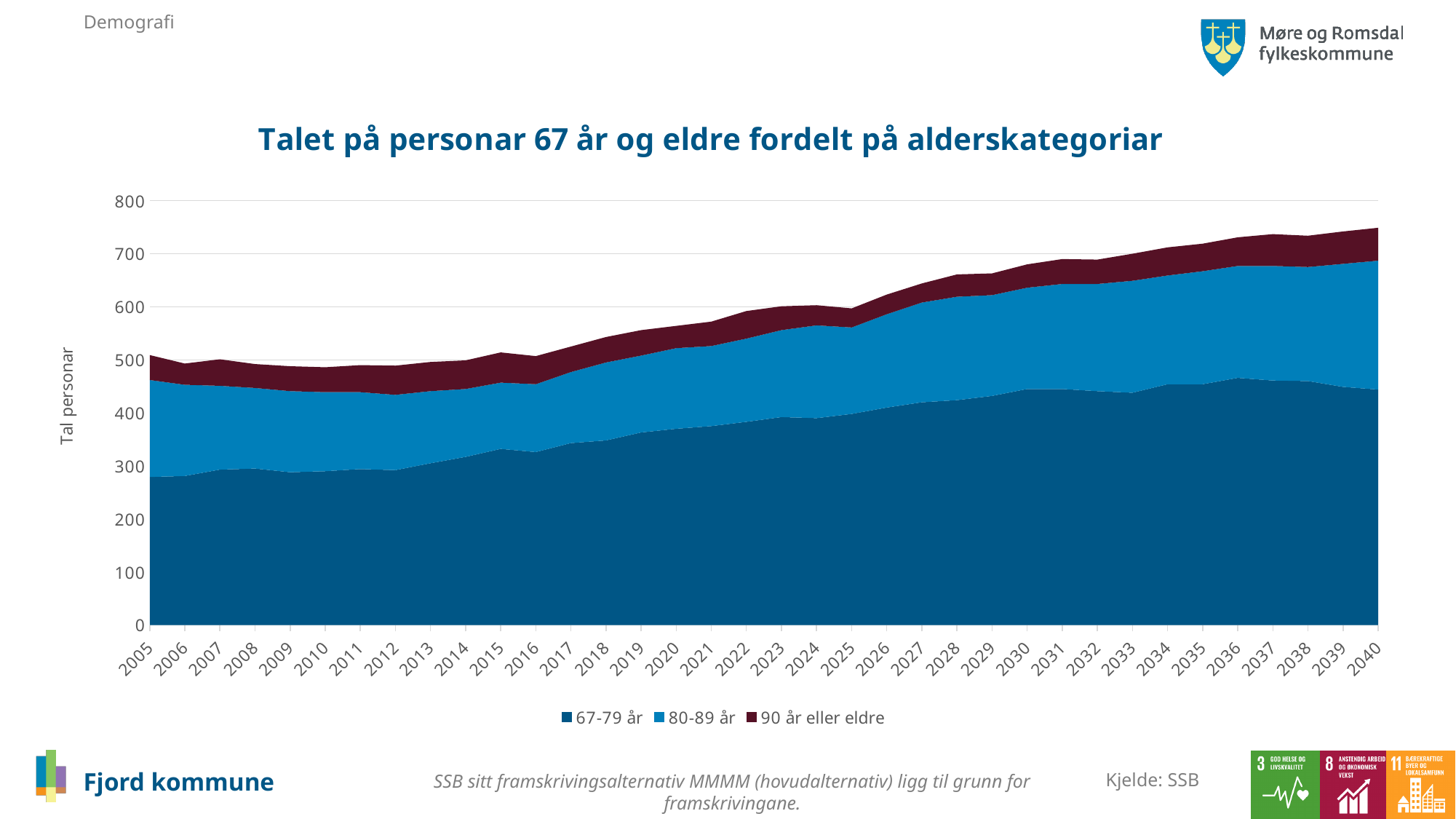
What is the first year shown on the x axis? 2005 Is the total value for 2005 greater or less than 600? less What kind of chart is shown on the slide? Stacked area chart Is the value for the 67-79 år series in 2040 greater or less than 400? greater Is the value for the 67-79 år series in 2005 greater or less than 300? less How many years are shown along the x axis? 36 Which year has the highest total number of persons 67 years and older? 2040 What is the last year shown on the x axis? 2040 Which is larger, the total for 2040 or the total for 2005? 2040 How many series does the legend list? 3 Does the total number of persons 67 years and older rise or fall from 2005 to 2040? Rise